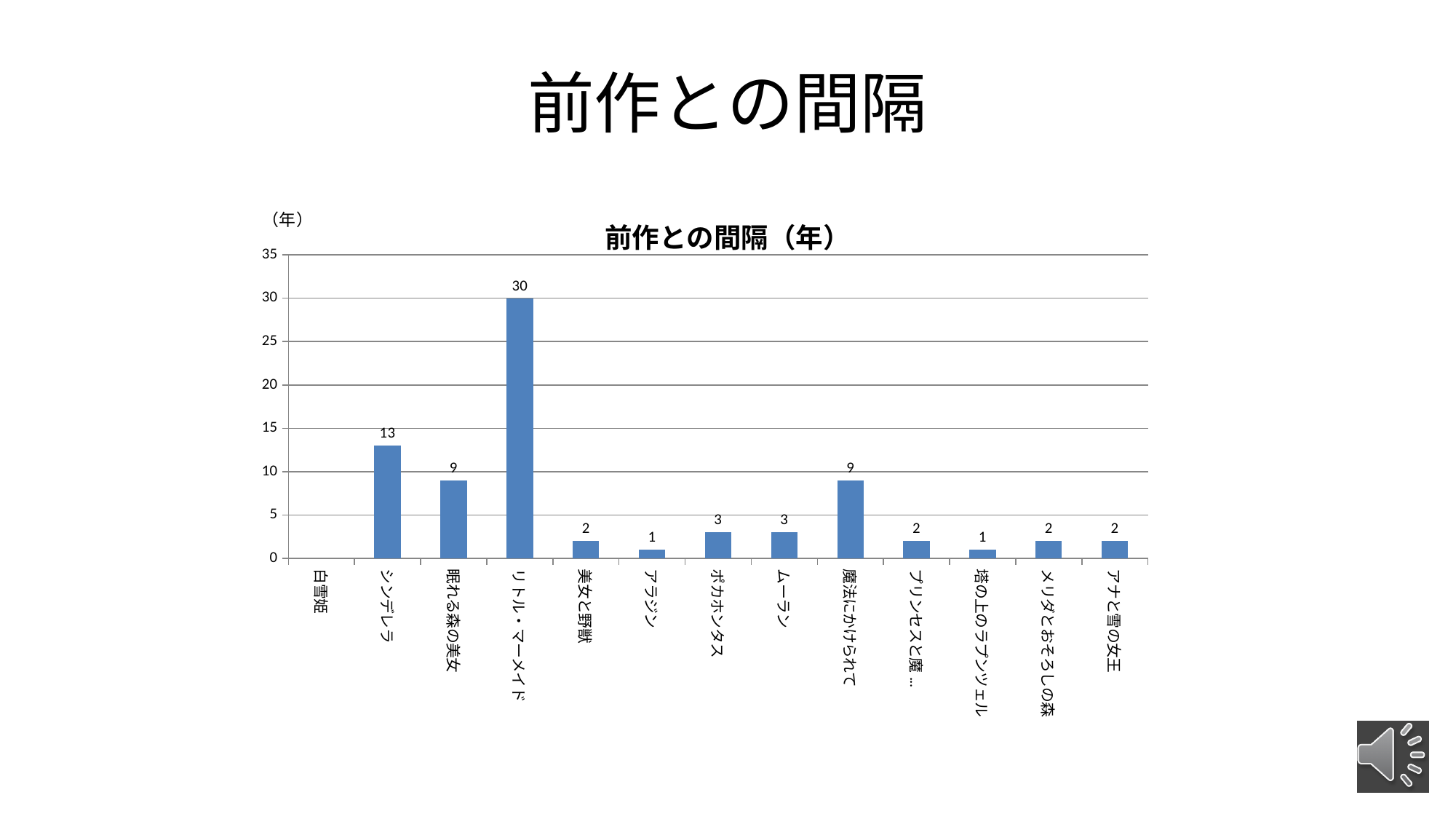
Is the value for リトル・マーメイド greater or less than 25? greater What is the value for シンデレラ? 13 What is the difference between the values for リトル・マーメイド and シンデレラ? 17 What type of chart is shown on the slide? bar chart Which category has the highest value? リトル・マーメイド What is the value for アナと雪の女王? 2 What is the value for 魔法にかけられて? 9 What is the title of the chart? 前作との間隔（年） How many categories are shown on the x axis? 13 Which is larger, the value for シンデレラ or the value for 眠れる森の美女? シンデレラ What is the value for リトル・マーメイド? 30 What is the difference between the values for 眠れる森の美女 and 美女と野獣? 7